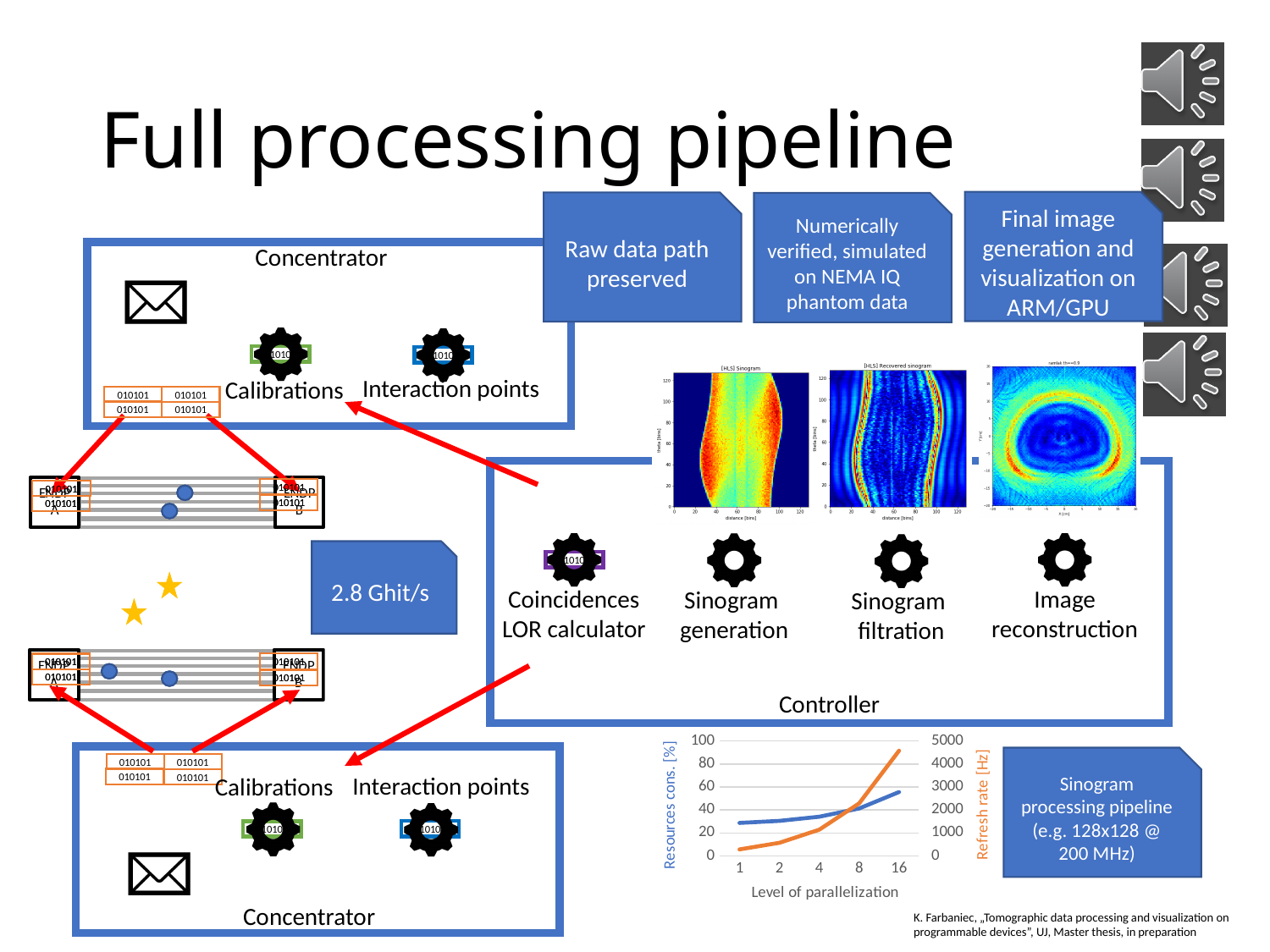
In the bottom-right line chart, what is the title of the x axis? Level of parallelization In the bottom-right line chart, is the resources consumption at parallelization level 1 greater or less than 20%? greater What kind of chart is shown at the bottom right of the slide? line chart In the bottom-right line chart, at which level of parallelization is the refresh rate highest? 16 In the bottom-right line chart, does the orange refresh rate line rise or fall as the level of parallelization increases? rise In the bottom-right line chart, at which level of parallelization is the resources consumption lowest? 1 In the bottom-right line chart, is the resources consumption at parallelization level 16 greater or less than 40%? greater In the bottom-right line chart, what is the label of the left vertical axis? Resources cons. [%] In the bottom-right line chart, does the blue resources consumption line rise or fall along the x axis? rise In the bottom-right line chart, how many levels of parallelization are marked on the x axis? 5 In the bottom-right line chart, is the refresh rate at parallelization level 1 greater or less than 1000 Hz? less